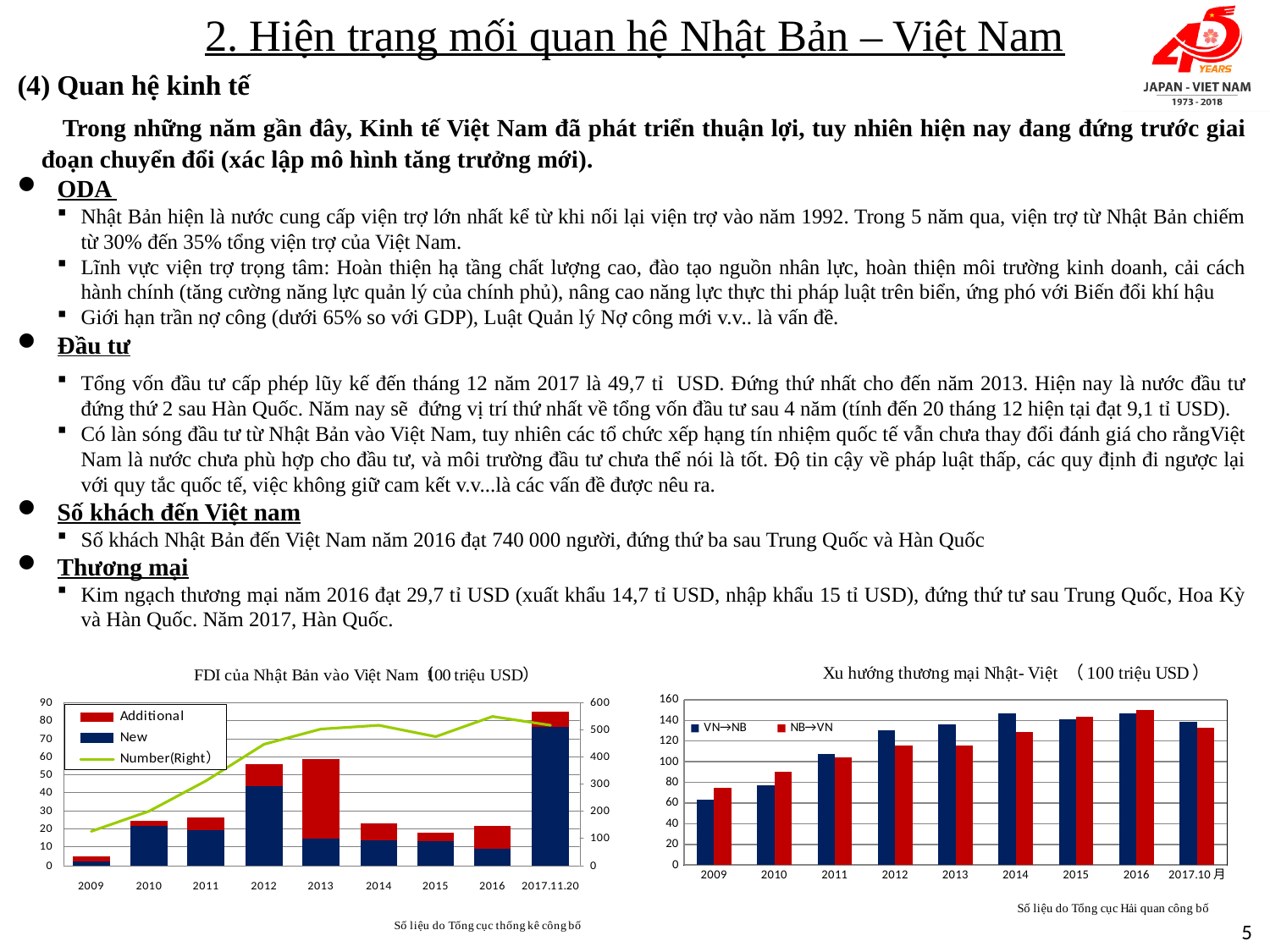
On the chart titled 'FDI của Nhật Bản vào Việt Nam', which category has the tallest stacked bar? 2017.11.20 On the chart titled 'Xu hướng thương mại Nhật- Việt', in which category is the NB→VN bar highest? 2016 On the chart titled 'FDI của Nhật Bản vào Việt Nam', what kind of chart is used for the Additional and New series? bar chart On the chart titled 'FDI của Nhật Bản vào Việt Nam', how many series does the legend list? 3 On the chart titled 'FDI của Nhật Bản vào Việt Nam', is the total stacked bar for 2012 greater or less than 50? greater On the chart titled 'Xu hướng thương mại Nhật- Việt', in 2014, which is larger: VN→NB or NB→VN? VN→NB On the chart titled 'FDI của Nhật Bản vào Việt Nam', which category has the shortest stacked bar? 2009 On the chart titled 'Xu hướng thương mại Nhật- Việt', is the NB→VN value for 2009 greater or less than 60? greater On the chart titled 'FDI của Nhật Bản vào Việt Nam', how many categories are shown on the x axis? 9 On the chart titled 'Xu hướng thương mại Nhật- Việt', how many categories are shown on the x axis? 9 On the chart titled 'FDI của Nhật Bản vào Việt Nam', does the Number(Right) line rise or fall from 2009 to 2013? rise On the chart titled 'Xu hướng thương mại Nhật- Việt', how many series does the legend list? 2